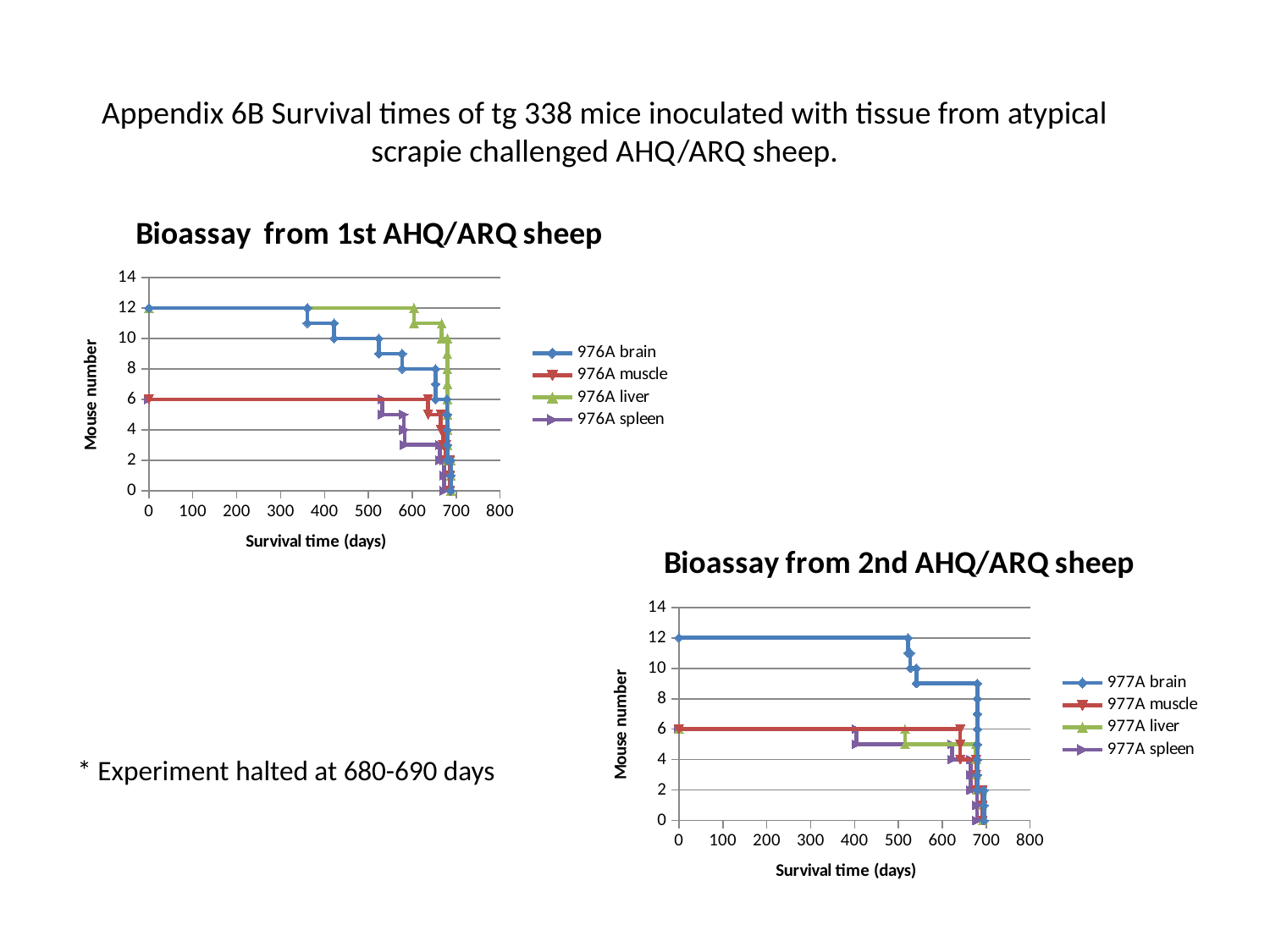
In the 'Bioassay from 2nd AHQ/ARQ sheep' chart, is the 977A brain value at 400 days greater or less than 10? greater In the 'Bioassay from 1st AHQ/ARQ sheep' chart, what is the mouse number for 976A brain at 0 days? 12 In the 'Bioassay from 1st AHQ/ARQ sheep' chart, at 0 days, which is larger: 976A brain or 976A spleen? 976A brain What kind of chart is the 'Bioassay from 1st AHQ/ARQ sheep' chart? line chart In the 'Bioassay from 1st AHQ/ARQ sheep' chart, what is the mouse number for 976A muscle at 0 days? 6 How many series does the legend of the 'Bioassay from 2nd AHQ/ARQ sheep' chart list? 4 In the 'Bioassay from 2nd AHQ/ARQ sheep' chart, which series starts with the highest mouse number at 0 days? 977A brain How many series does the legend of the 'Bioassay from 1st AHQ/ARQ sheep' chart list? 4 In the 'Bioassay from 2nd AHQ/ARQ sheep' chart, what is the mouse number for 977A brain at 0 days? 12 What is the x-axis title of the 'Bioassay from 1st AHQ/ARQ sheep' chart? Survival time (days) In the 'Bioassay from 1st AHQ/ARQ sheep' chart, do the mouse numbers rise or fall as survival time increases? fall In the 'Bioassay from 2nd AHQ/ARQ sheep' chart, what is the mouse number for 977A muscle at 0 days? 6